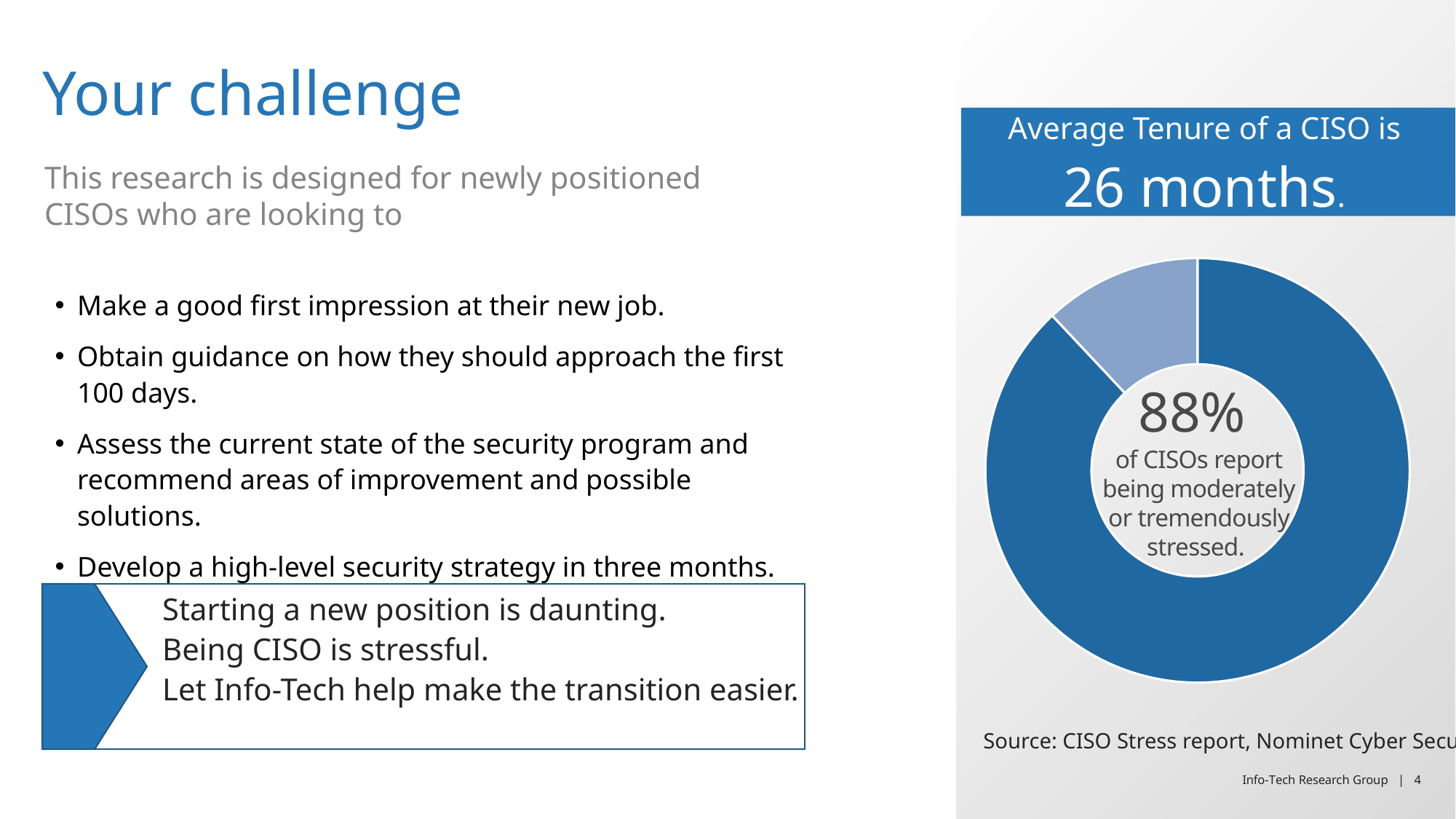
What does the text inside the donut chart say the 88% refers to? CISOs who report being moderately or tremendously stressed Is the light blue slice of the donut chart greater or less than a quarter of the chart? less What kind of chart is shown on the right side of the slide? Donut (pie) chart What share of CISOs does the donut chart say report being moderately or tremendously stressed? 88% How many slices does the donut chart have? 2 Is the dark blue slice of the donut chart greater or less than half of the chart? greater Which slice of the donut chart is larger, the dark blue slice or the light blue slice? The dark blue slice What percentage is printed in the centre of the donut chart? 88% What colour is the largest slice of the donut chart? Dark blue